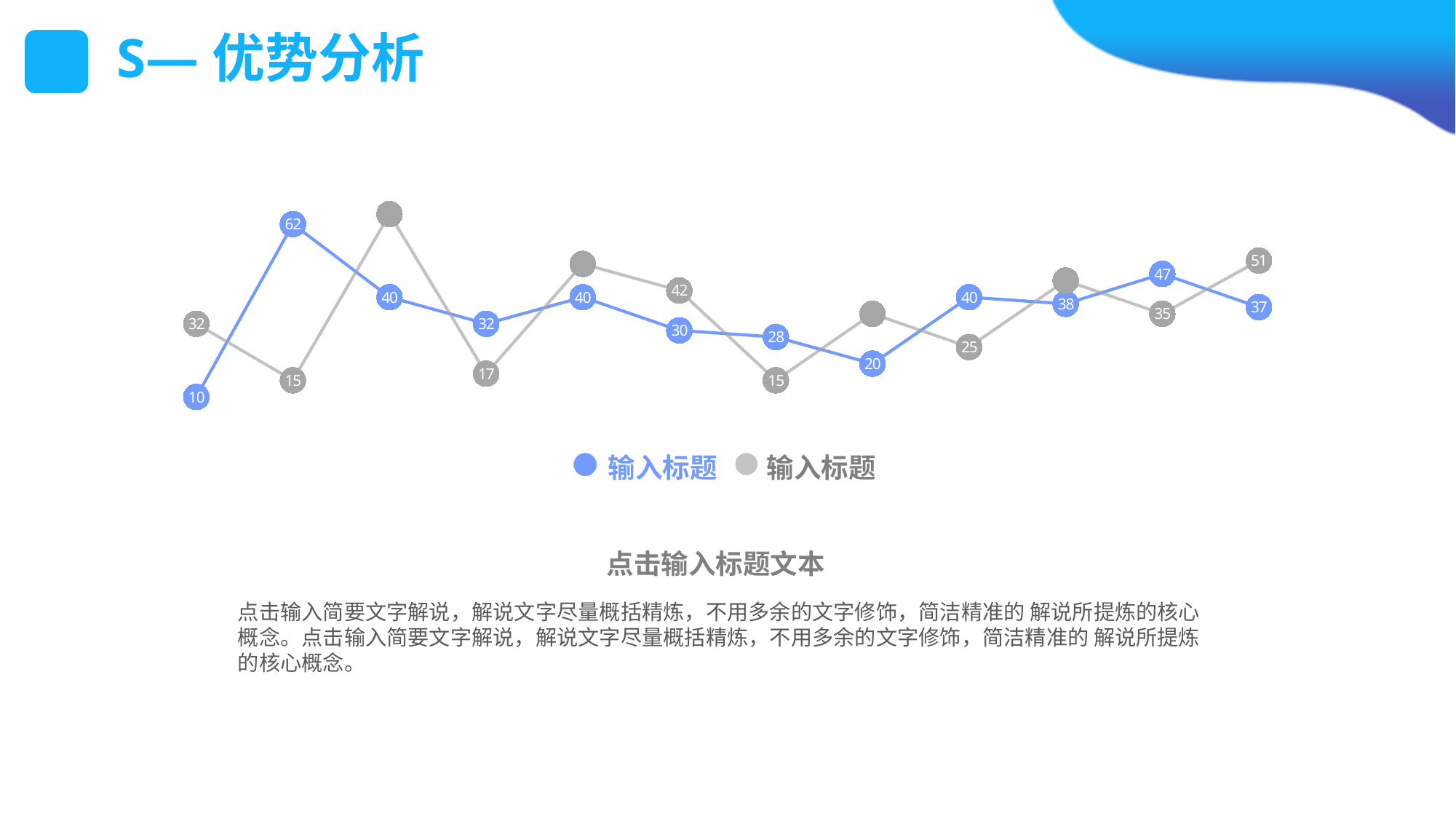
What type of chart is shown on the slide? line chart What is the value of the first (leftmost) point of the blue series? 10 What is the value of the last (rightmost) point of the gray series? 51 How many data points does the blue series have? 12 At the rightmost point, which series has the larger value, blue or gray? gray What is the highest labeled value in the blue series? 62 What is the difference between the second point (62) and the first point (10) of the blue series? 52 What is the difference between the gray series and the blue series at the rightmost point? 14 What is the lowest labeled value in the blue series? 10 Does the blue series rise or fall from its first point to its second point? rise How many series does the legend list? 2 What is the value of the last (rightmost) point of the blue series? 37